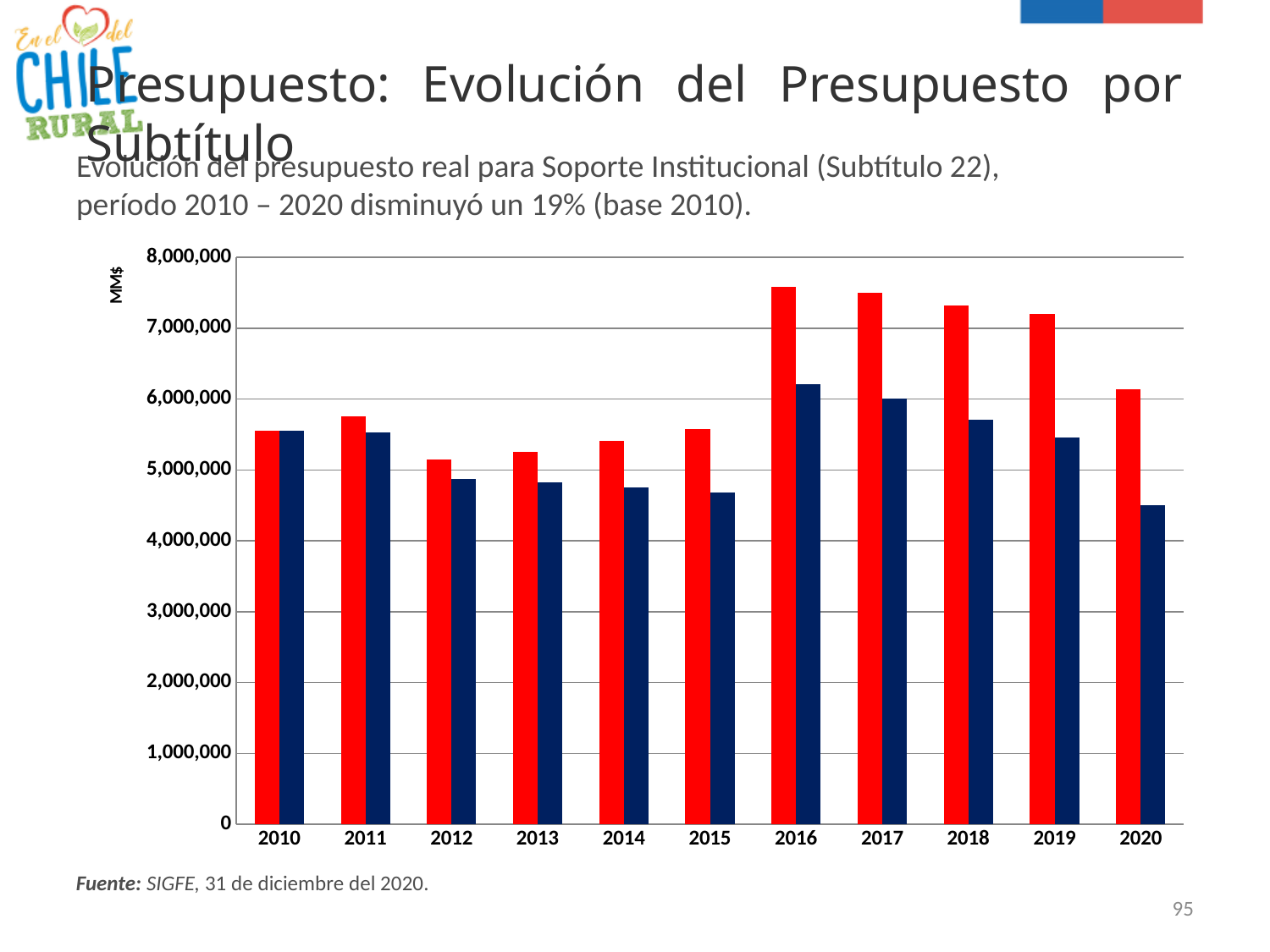
In 2020, which bar is taller, the red bar or the dark blue bar? the red bar Is the value of the dark blue bar for 2020 greater or less than 5,000,000? less What unit label is shown on the vertical axis of the chart? MM$ How many years are shown along the x axis of the chart? 11 How many bars are plotted for each year in the chart? 2 In which year is the dark blue bar the shortest? 2020 Is the value of the red bar for 2016 greater or less than 7,000,000? greater Do the dark blue bars rise or fall from 2016 to 2020? fall In which year is the red bar the tallest? 2016 In which year is the dark blue bar the tallest? 2016 Is the value of the dark blue bar for 2016 greater or less than 6,000,000? greater What kind of chart is shown on the slide? bar chart